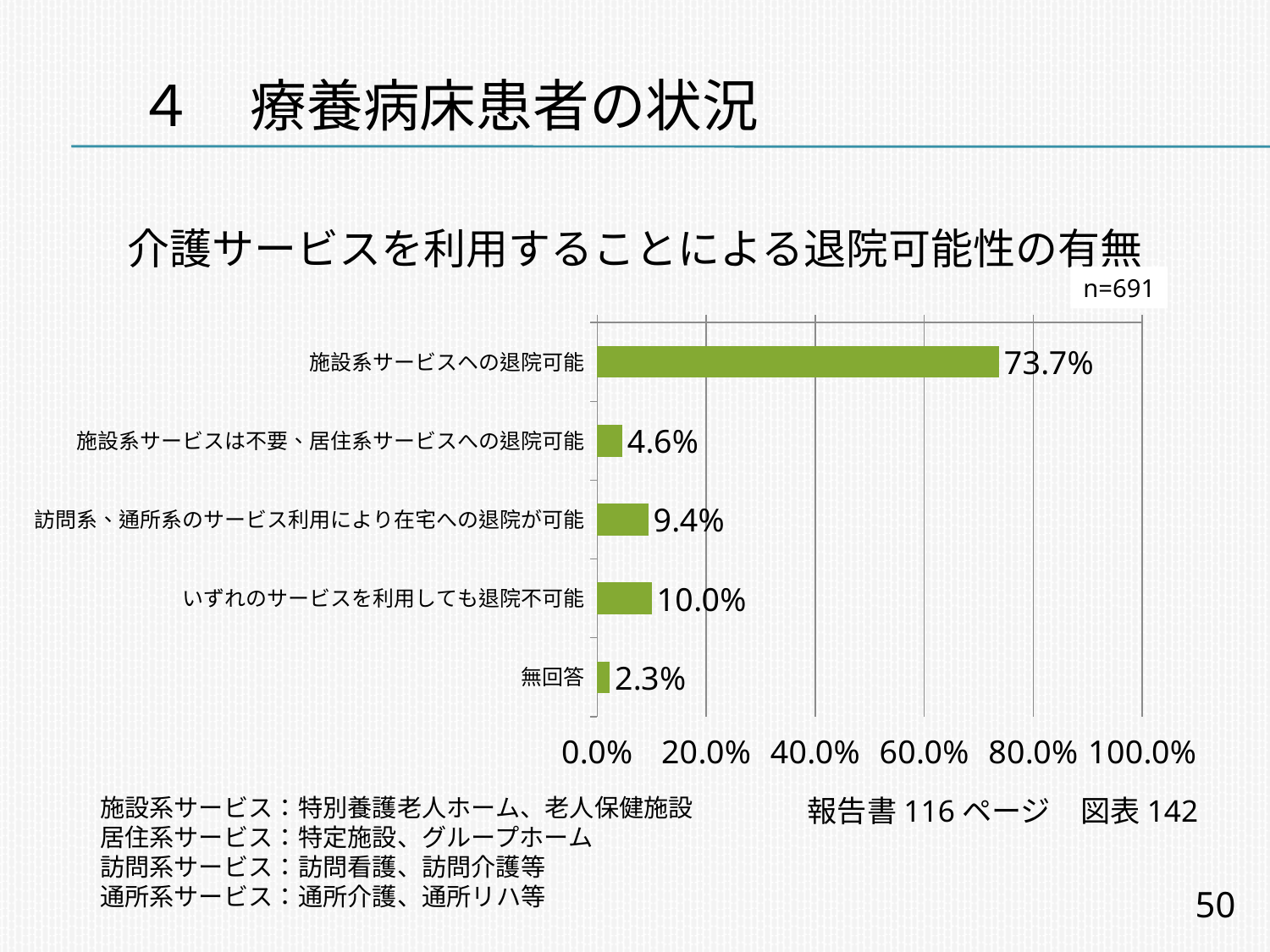
Which is larger: 訪問系、通所系のサービス利用により在宅への退院が可能 or 施設系サービスは不要、居住系サービスへの退院可能? 訪問系、通所系のサービス利用により在宅への退院が可能 How many categories are shown in the chart? 5 Which category has the highest value? 施設系サービスへの退院可能 What is the sample size (n) shown for the chart? n=691 What is the value for いずれのサービスを利用しても退院不可能? 10.0% What is the value for 施設系サービスへの退院可能? 73.7% What is the value for 無回答? 2.3% Which category has the lowest value? 無回答 What is the difference between 施設系サービスへの退院可能 and いずれのサービスを利用しても退院不可能? 63.7% What is the value for 訪問系、通所系のサービス利用により在宅への退院が可能? 9.4% What is the value for 施設系サービスは不要、居住系サービスへの退院可能? 4.6% What kind of chart is shown on the slide? Bar chart